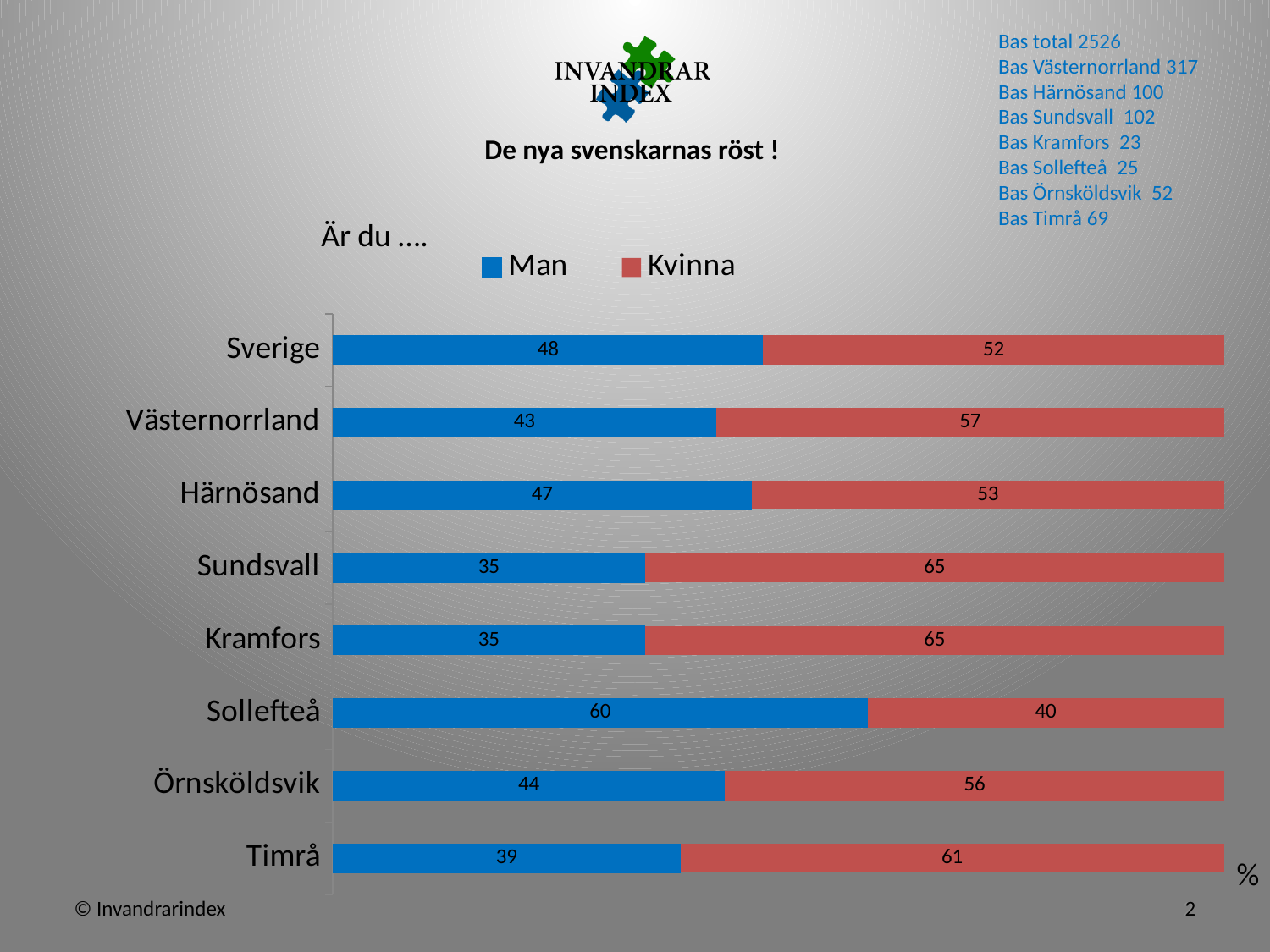
What kind of chart is shown on the slide? Stacked bar chart What is the difference between the Kvinna and Man values for Västernorrland? 14 How many categories are shown on the chart? 8 What is the total of the stacked bar for Örnsköldsvik? 100 Which is larger in Härnösand, the Man value or the Kvinna value? Kvinna What is the title of the chart? Är du …. What is the value for Man in Sverige? 48 How many series does the legend list? 2 What is the value for Man in Timrå? 39 Which category has the highest value for Man? Sollefteå Which category has the lowest value for Kvinna? Sollefteå What is the value for Kvinna in Sundsvall? 65